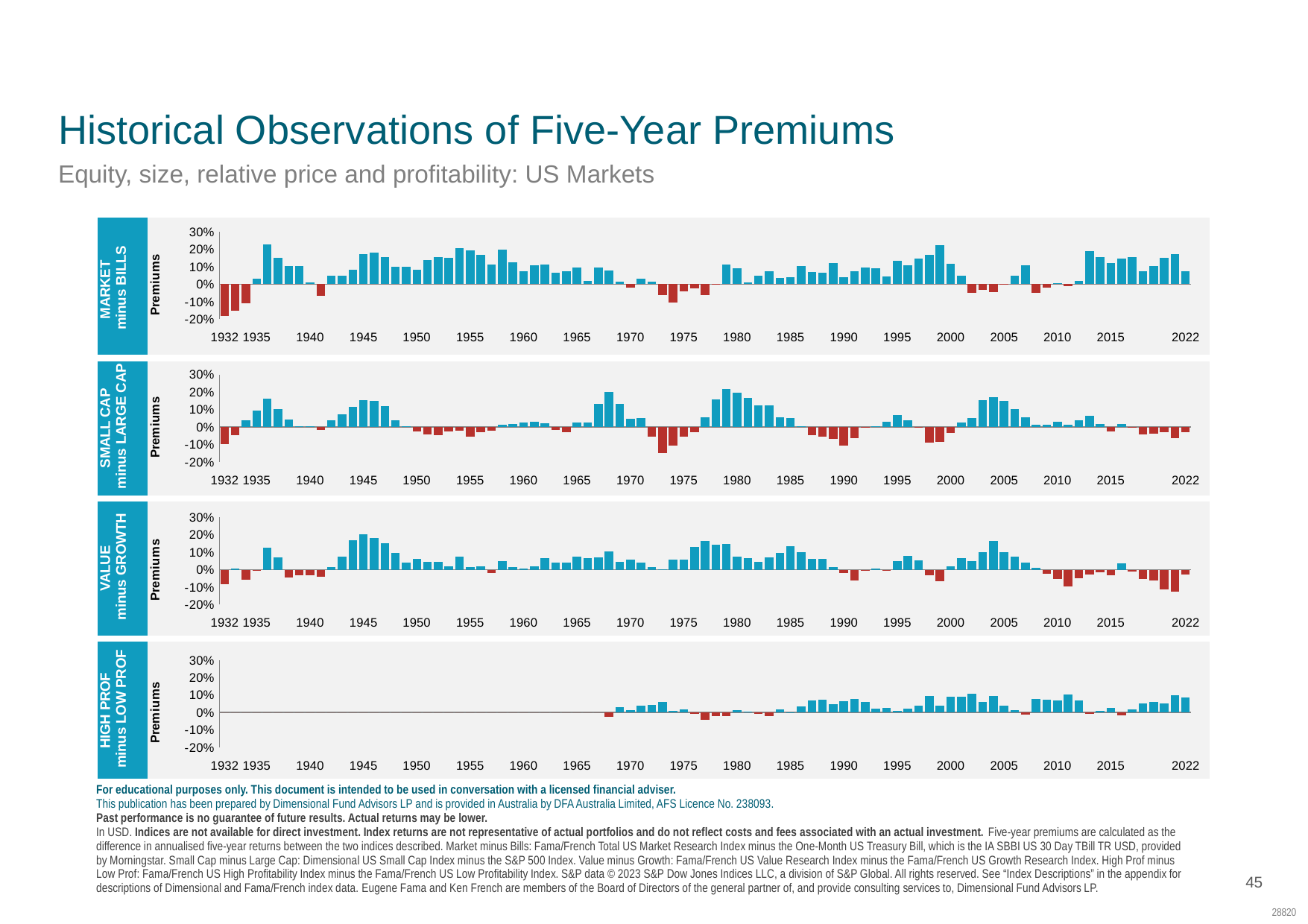
What is the last year labelled on the x axis of the charts? 2022 What is the title of the slide containing the charts? Historical Observations of Five-Year Premiums In the 'HIGH PROF minus LOW PROF' chart, is the highest bar greater or less than 20%? less In the 'MARKET minus BILLS' chart, is the value for 1932 greater or less than -10%? less What kind of chart is used in the 'MARKET minus BILLS' panel? bar chart What is the first year labelled on the x axis of the charts? 1932 What label appears on the vertical axis of each chart panel? Premiums In the 'VALUE minus GROWTH' chart, is the value for 1945 greater or less than 10%? greater How many chart panels are shown on the slide? 4